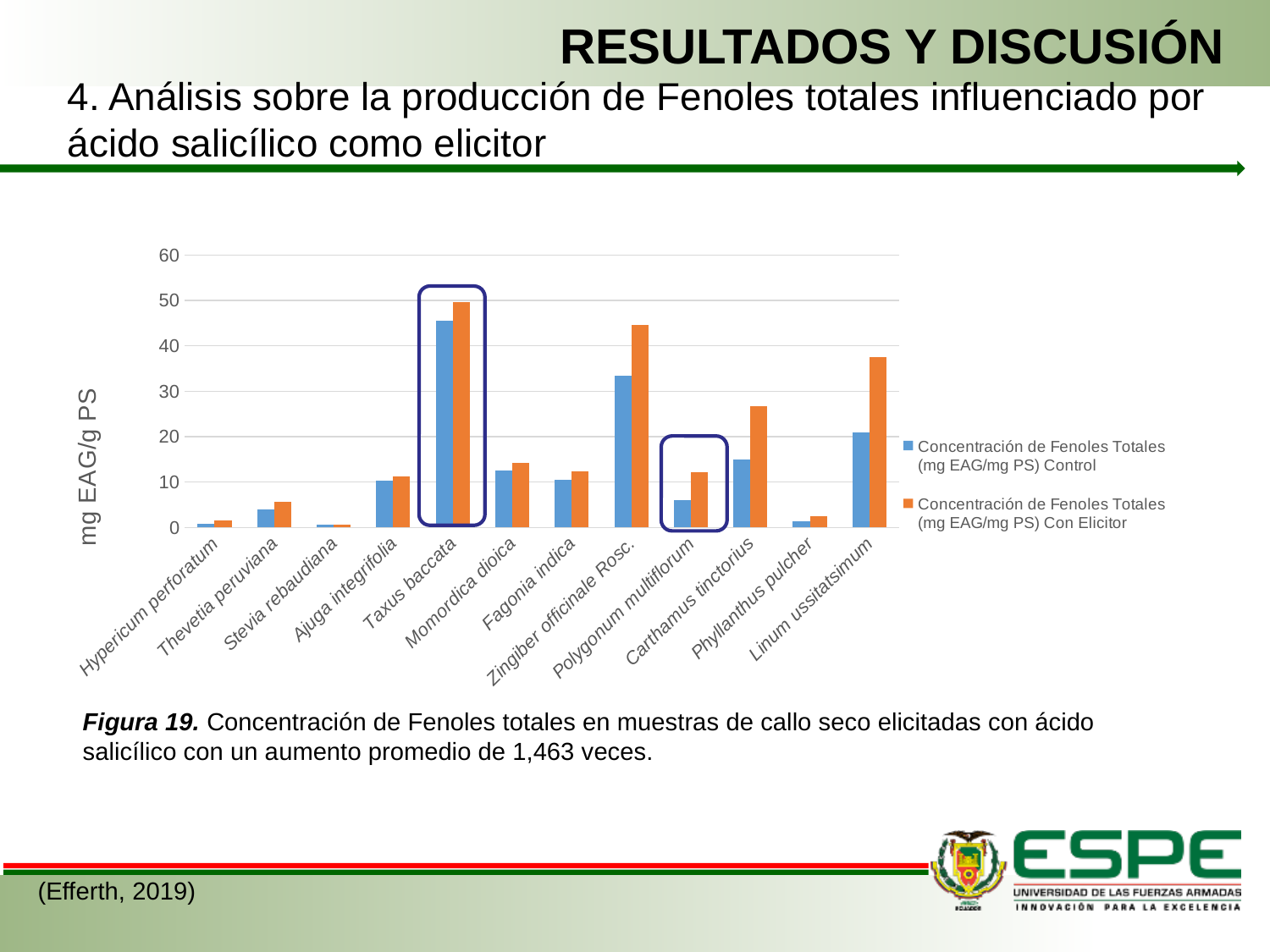
Is the Con Elicitor value for Zingiber officinale Rosc. greater or less than 40? greater Is the Con Elicitor value for Linum ussitatsimum greater or less than 30? greater Is the Control value for Taxus baccata greater or less than 40? greater Which is larger for Zingiber officinale Rosc.: the Control value or the Con Elicitor value? Con Elicitor Which species has the highest Concentración de Fenoles Totales Control? Taxus baccata What is the label on the y axis of the chart? mg EAG/g PS Which species has the highest Concentración de Fenoles Totales Con Elicitor? Taxus baccata How many series does the chart's legend list? 2 Which species has the larger Con Elicitor value: Zingiber officinale Rosc. or Linum ussitatsimum? Zingiber officinale Rosc. How many plant species (categories) are shown on the x axis of the chart? 12 What kind of chart is shown on the slide? bar chart